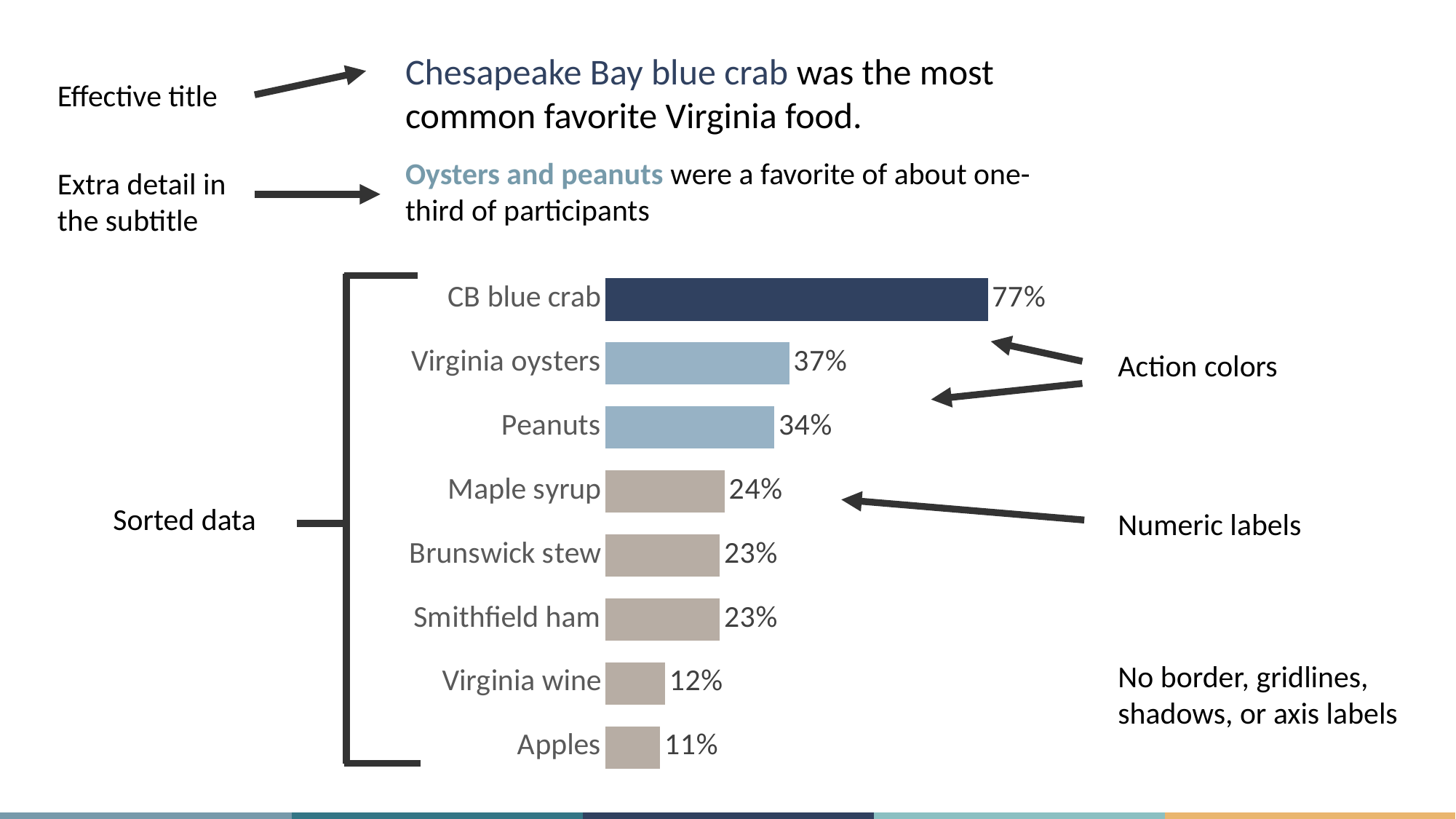
What is the value for Peanuts? 34% Which category has the highest value? CB blue crab Which category has the lowest value? Apples What is the value for Virginia wine? 12% What kind of chart is shown on the slide? Bar chart Which is larger, the value for Virginia oysters or the value for Peanuts? Virginia oysters Which two categories both have a value of 23%? Brunswick stew and Smithfield ham What is the difference between the values for Maple syrup and Apples? 13% What is the difference between the values for CB blue crab and Virginia oysters? 40% What is the value for CB blue crab? 77% What colour is the bar for CB blue crab? Dark navy blue How many categories are shown in the chart? 8